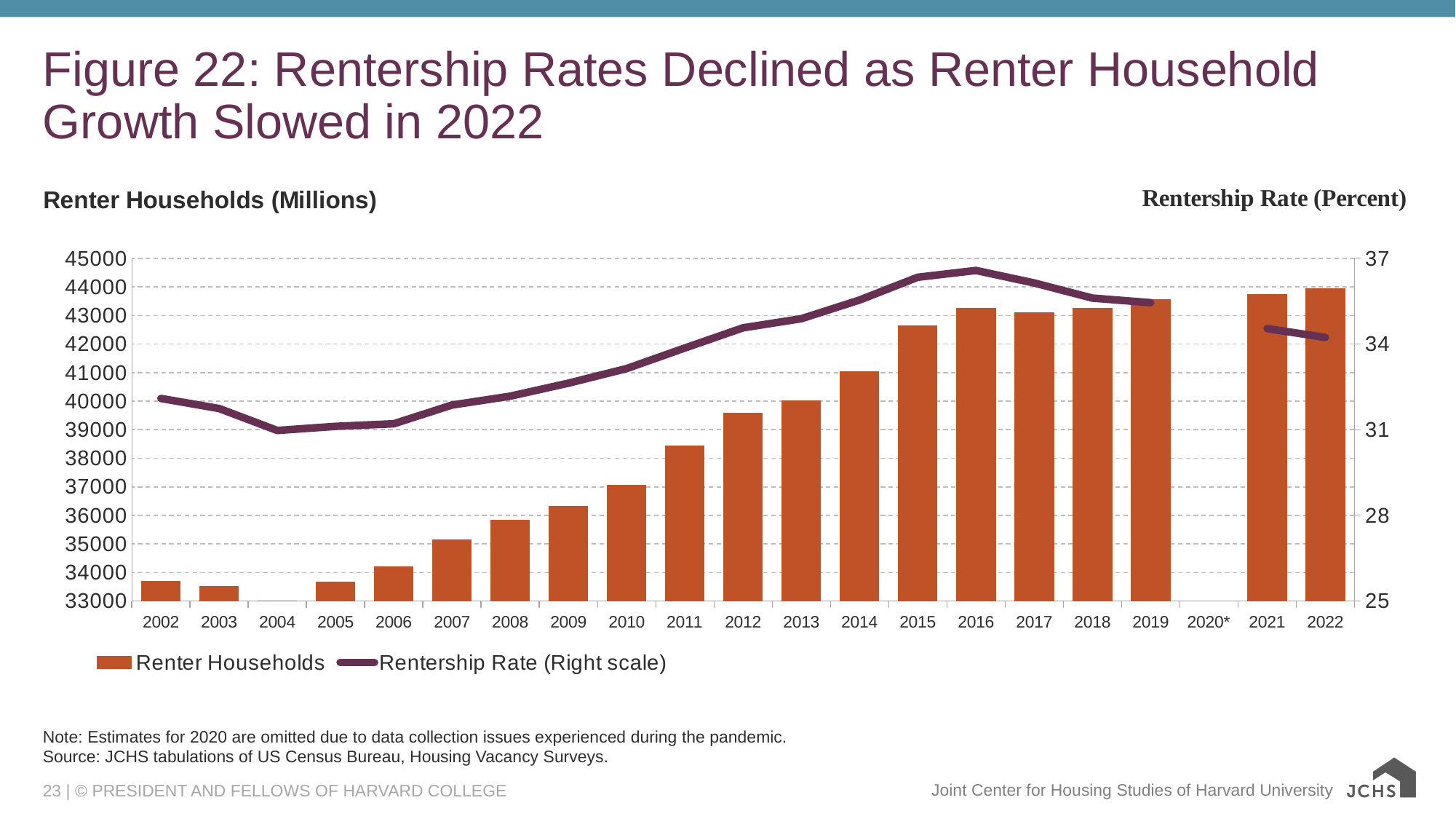
What kind of chart is shown on the slide? A combined bar and line chart Which year has the lowest Rentership Rate? 2004 Which year has the highest Rentership Rate? 2016 Which year has the tallest Renter Households bar? 2022 Which year on the x axis has no data plotted? 2020* Is the Renter Households value for 2007 greater or less than 36000? less Does the Rentership Rate line rise or fall from 2016 to 2022? fall Is the Renter Households value for 2011 greater or less than 38000? greater How many series does the legend list? 2 Which year has the larger Renter Households value, 2010 or 2012? 2012 Do the Renter Households bars rise or fall from 2005 to 2016? rise Is the Rentership Rate for 2019 greater or less than 34? greater